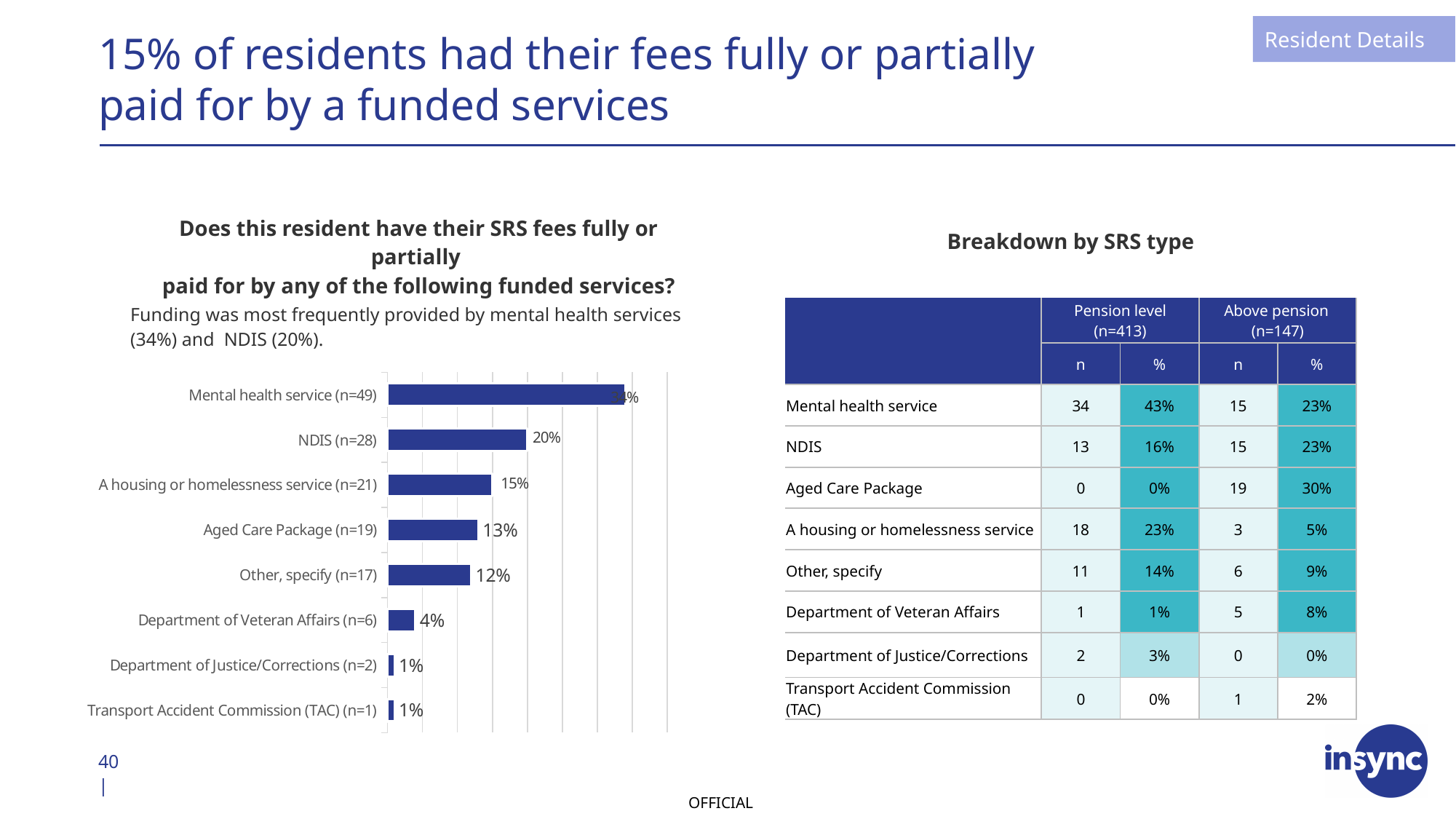
Which funded service has the highest percentage in the bar chart? Mental health service (n=49) What percentage is shown for Department of Veteran Affairs (n=6) in the bar chart? 4% What type of chart is used to show the funded services breakdown? Bar chart What is the difference in percentage points between Mental health service (n=49) and NDIS (n=28)? 14 percentage points What percentage is shown for Department of Justice/Corrections (n=2) in the bar chart? 1% What is the difference in percentage points between NDIS (n=28) and A housing or homelessness service (n=21)? 5 percentage points What percentage is shown for Aged Care Package (n=19) in the bar chart? 13% What percentage is shown for NDIS (n=28) in the bar chart? 20% What percentage is shown for Other, specify (n=17) in the bar chart? 12% How many funded service categories are plotted in the bar chart? 8 Which has a larger percentage in the bar chart, NDIS (n=28) or Aged Care Package (n=19)? NDIS (n=28) What percentage is shown for Mental health service (n=49) in the bar chart? 34%